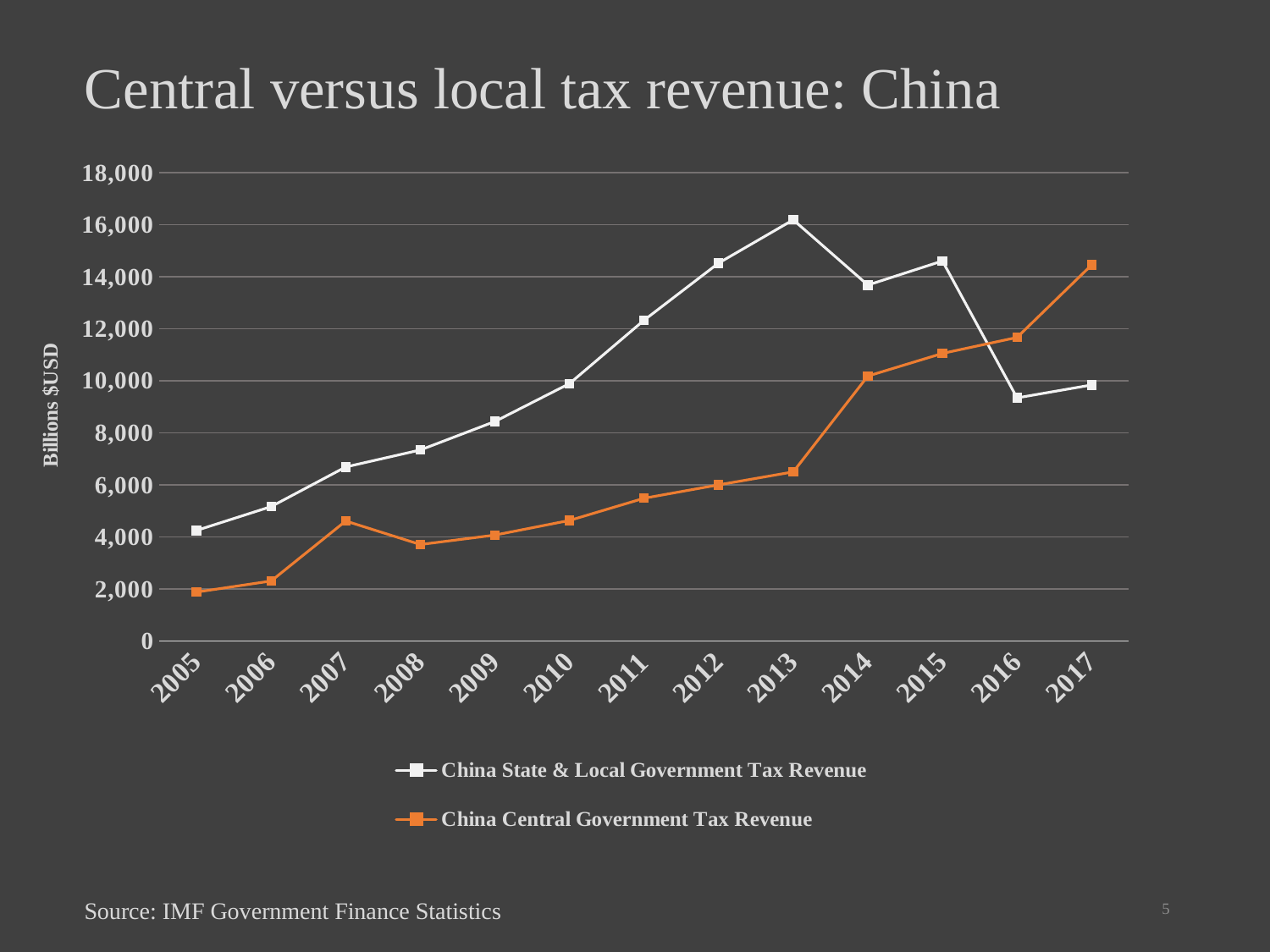
Is the value for China State & Local Government Tax Revenue in 2013 greater or less than 14,000? greater Is the value for China Central Government Tax Revenue in 2013 greater or less than 8,000? less In 2012, which series has the higher value: China State & Local Government Tax Revenue or China Central Government Tax Revenue? China State & Local Government Tax Revenue In which year is China Central Government Tax Revenue lowest? 2005 In 2016, which series has the higher value: China State & Local Government Tax Revenue or China Central Government Tax Revenue? China Central Government Tax Revenue In which year does China State & Local Government Tax Revenue reach its highest value? 2013 What kind of chart is shown on the slide? line chart How many years are plotted along the x axis? 13 Does China Central Government Tax Revenue rise or fall from 2013 to 2017? rise How many series does the legend list? 2 In which year does China Central Government Tax Revenue reach its highest value? 2017 In which year is China State & Local Government Tax Revenue lowest? 2005